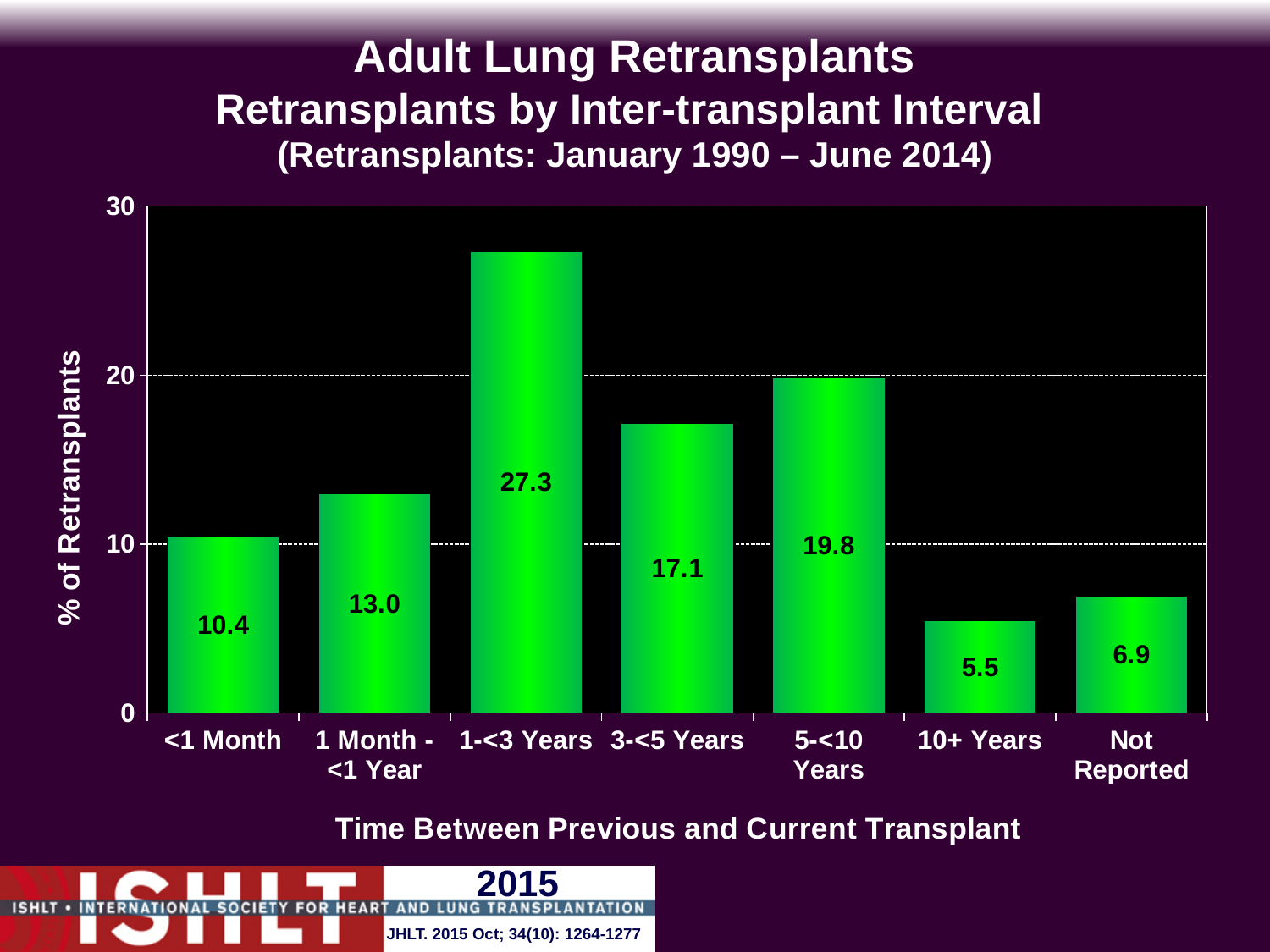
Which is larger, the value for <1 Month or the value for 1 Month - <1 Year? 1 Month - <1 Year Which inter-transplant interval category has the highest percentage of retransplants? 1-<3 Years What is the label of the y axis? % of Retransplants How many inter-transplant interval categories are shown on the x axis? 7 Is the value for 5-<10 Years greater or less than 20? less What percentage of retransplants is shown for the Not Reported category? 6.9 What is the value for the 10+ Years category? 5.5 What is the difference between the values for 5-<10 Years and 3-<5 Years? 2.7 Which category has the lowest percentage of retransplants? 10+ Years What is the label of the x axis? Time Between Previous and Current Transplant What percentage of retransplants had an inter-transplant interval of 1-<3 Years? 27.3 What kind of chart is shown on the slide? bar chart